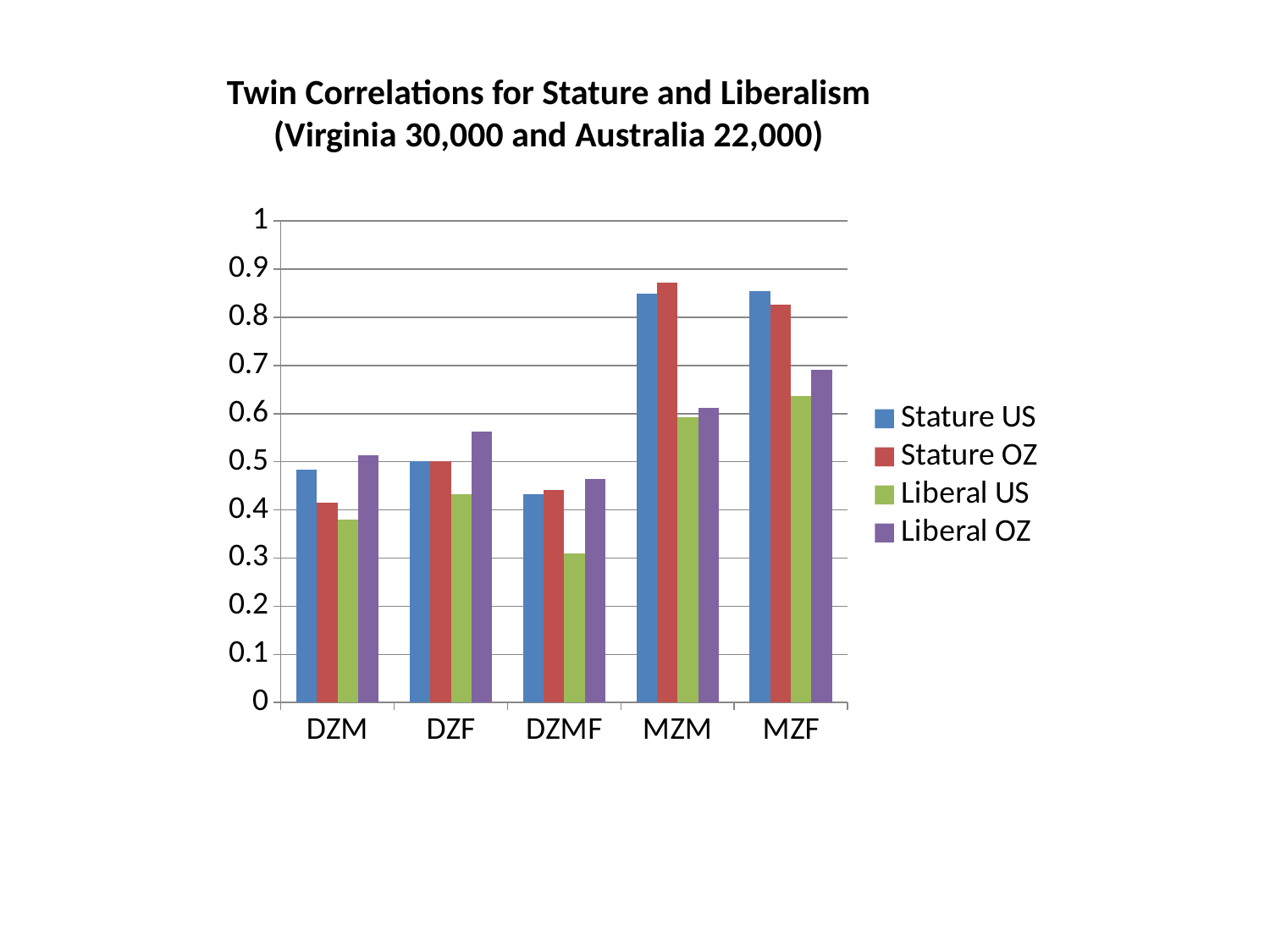
Is the value for Stature OZ in the MZM category greater or less than 0.8? greater What is the title of the chart? Twin Correlations for Stature and Liberalism (Virginia 30,000 and Australia 22,000) What kind of chart is shown on the slide? bar chart In the MZM category, which is larger: Stature OZ or Liberal OZ? Stature OZ How many categories are shown on the x axis? 5 Which category has the highest value for Liberal US? MZF Is the value for Liberal OZ in the DZF category greater or less than 0.5? greater Which category has the lowest value for Liberal US? DZMF How many series does the legend list? 4 Is the value for Liberal OZ in the MZF category greater or less than 0.6? greater Which category has the lowest value for Liberal OZ? DZMF